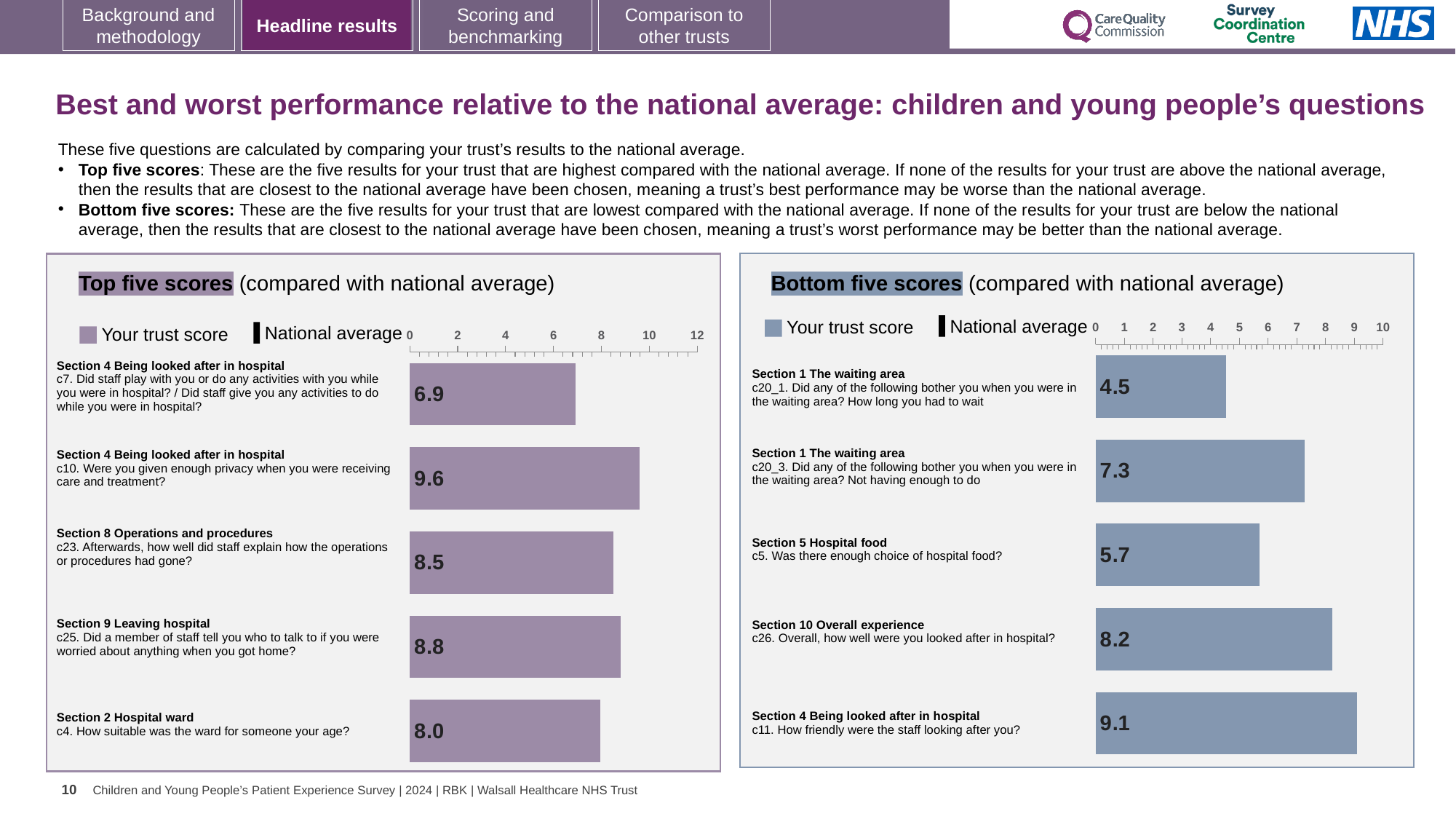
In the Top five scores chart, what is the difference between the trust scores for c10 and c7? 2.7 In the Top five scores chart, what is the trust score for c10 (Were you given enough privacy when you were receiving care and treatment?)? 9.6 In the Top five scores chart, which has the larger trust score: c23 or c25? c25 In the Bottom five scores chart, what is the trust score for c20_1 (How long you had to wait)? 4.5 In the Bottom five scores chart, what is the trust score for c26 (Overall, how well were you looked after in hospital?)? 8.2 In the Top five scores chart, which question has the lowest trust score? c7. Did staff play with you or do any activities with you while you were in hospital? What type of chart is the Top five scores chart? Bar chart How many entries does the legend of the Bottom five scores chart list? 2 In the Bottom five scores chart, which question has the highest trust score? c11. How friendly were the staff looking after you? How many questions are shown in the Bottom five scores chart? 5 In the Bottom five scores chart, what is the difference between the trust scores for c11 and c20_1? 4.6 In the Top five scores chart, what is the trust score for c4 (How suitable was the ward for someone your age?)? 8.0